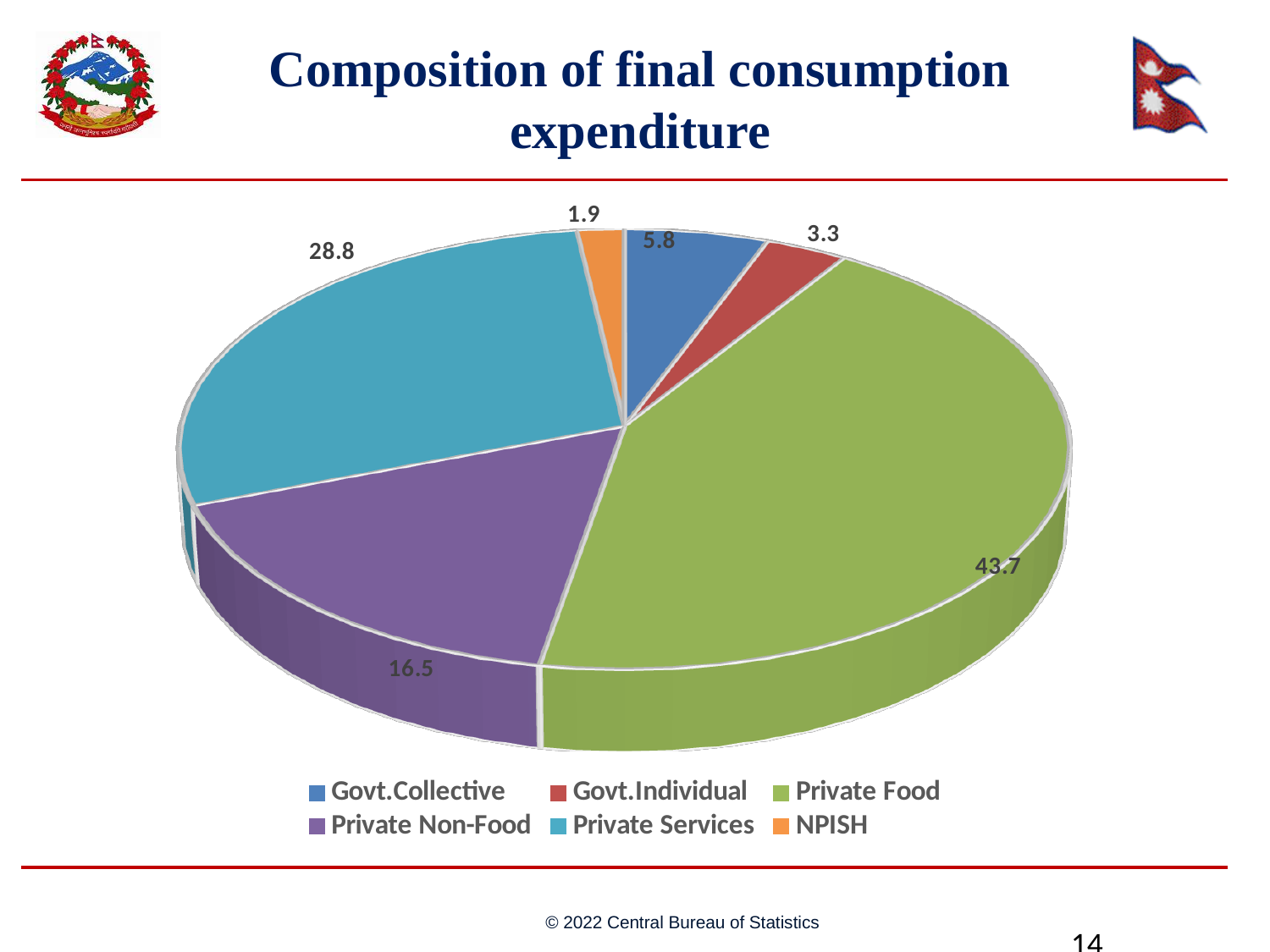
What is the value shown for Govt.Collective? 5.8 What is the title of the chart on the slide? Composition of final consumption expenditure Which colour represents Private Non-Food in the legend? Purple What is the value shown for Private Food? 43.7 What is the difference between the values for Private Food and Private Services? 14.9 How many categories does the pie chart show? 6 Which is larger, Private Non-Food or Govt.Individual? Private Non-Food What is the value shown for NPISH? 1.9 What type of chart is shown on the slide? Pie chart What is the value shown for Private Services? 28.8 Which category has the largest slice of the pie? Private Food Which category has the smallest slice of the pie? NPISH